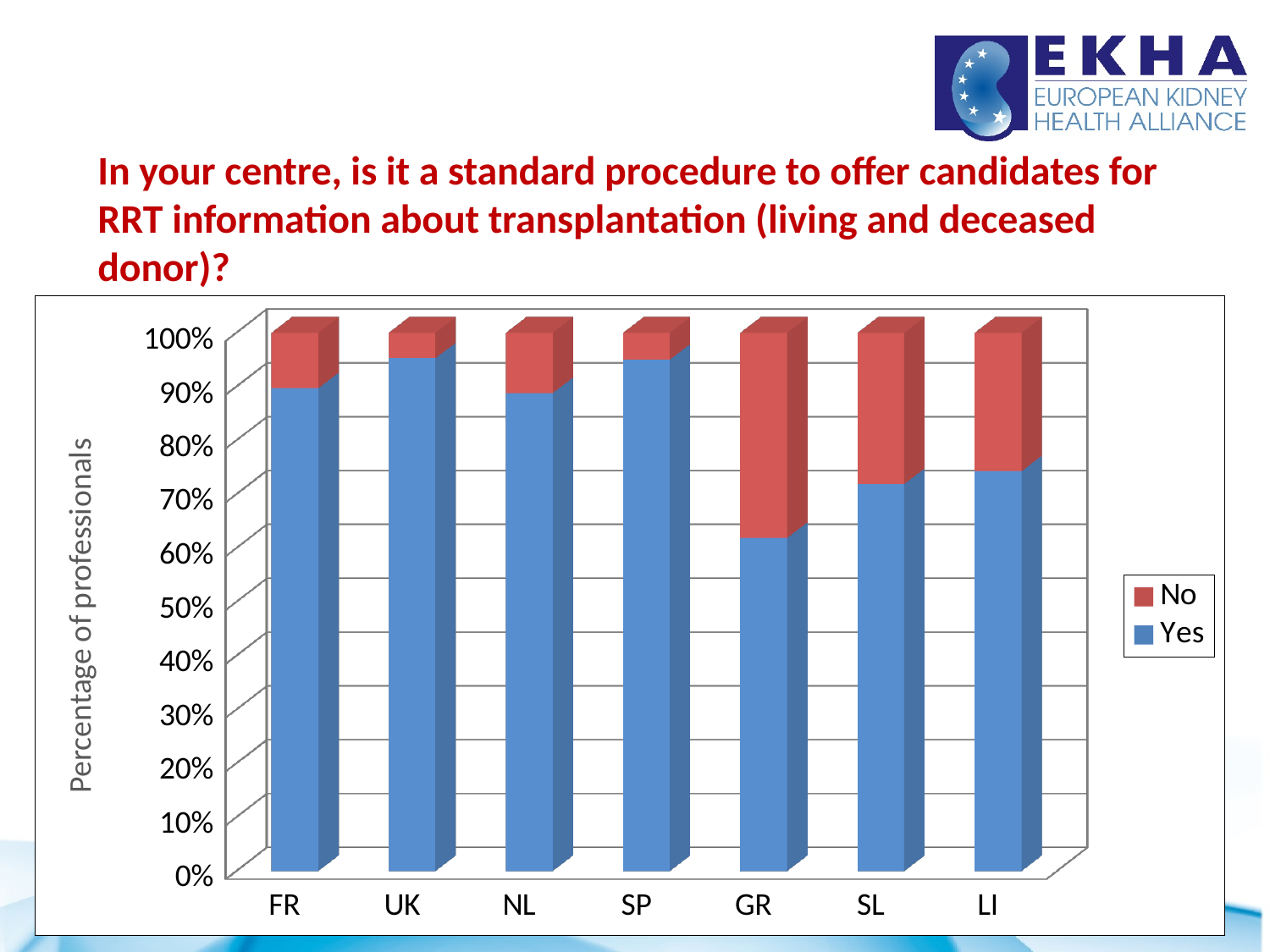
Which has the larger 'Yes' share, UK or GR? UK Is the 'Yes' value for SL greater or less than 60%? greater Which colour represents the 'Yes' series in the chart? Blue Which country has the lowest 'Yes' share in the chart? GR Is the 'Yes' value for GR greater or less than 70%? less Which country has the largest 'No' share in the chart? GR How many countries are shown on the x axis of the chart? 7 Is the 'Yes' value for LI greater or less than 80%? less What is the title of the chart's vertical axis? Percentage of professionals How many series does the chart's legend list? 2 What kind of chart is shown on the slide? Stacked bar chart